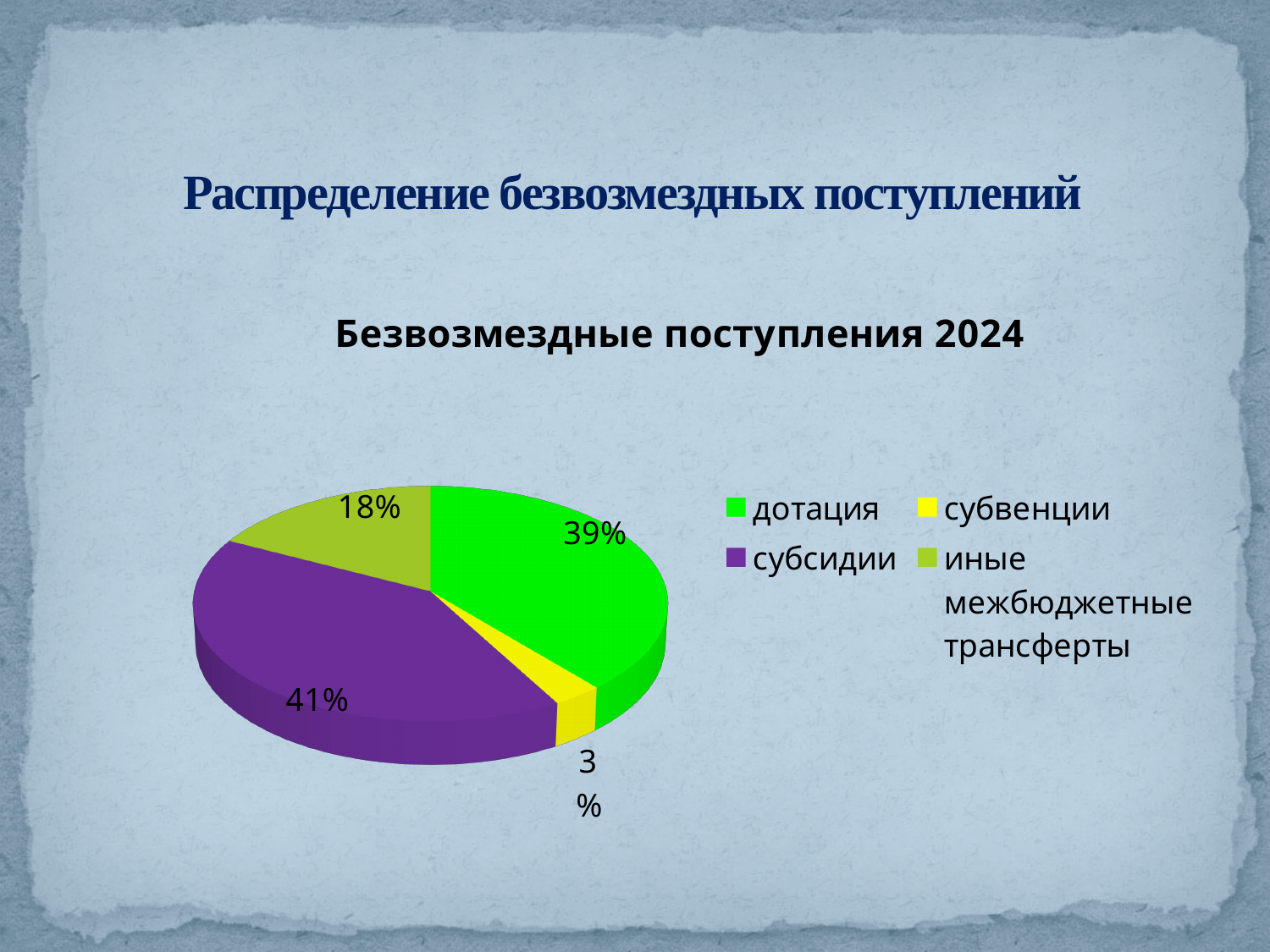
What share of the pie does субвенции have? 3% What kind of chart is shown on the slide? pie chart Which category has the smallest share of the pie? субвенции What share of the pie does субсидии have? 41% What share of the pie does дотация have? 39% Which has a larger share, дотация or иные межбюджетные трансферты? дотация What share of the pie does иные межбюджетные трансферты have? 18% How many slices does the pie chart have? 4 Which category has the largest share of the pie? субсидии What is the title of the chart? Безвозмездные поступления 2024 What is the difference between the shares of дотация and иные межбюджетные трансферты? 21% What is the difference between the shares of субсидии and дотация? 2%